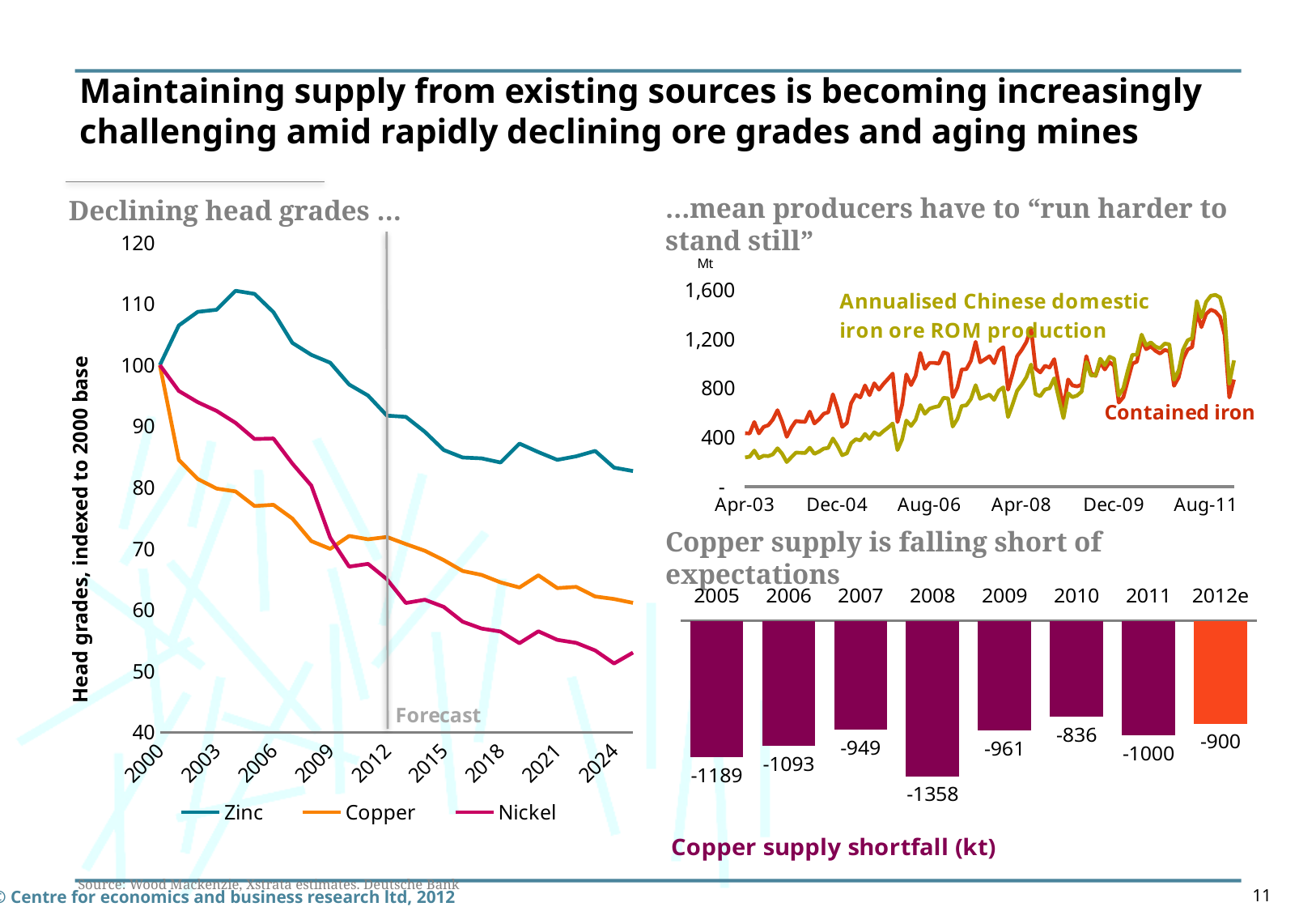
What kind of chart is the 'Copper supply is falling short of expectations' chart? Bar chart In the 'Copper supply is falling short of expectations' chart, which year shows the larger shortfall, 2011 or 2012e? 2011 How many bars are in the 'Copper supply is falling short of expectations' chart? 8 In the 'Copper supply is falling short of expectations' chart, which year has the lowest value? 2008 In the 'Copper supply is falling short of expectations' chart, which year has the highest value? 2010 How many series does the legend of the 'Declining head grades ...' chart list? 3 In the 'Copper supply is falling short of expectations' chart, what is the value for 2008? -1358 In the 'Declining head grades ...' chart, is the value for Nickel in 2024 greater or less than 60? less In the 'Declining head grades ...' chart, which series is higher in 2012, Zinc or Nickel? Zinc In the 'Copper supply is falling short of expectations' chart, what is the difference between the values for 2005 and 2006? 96 In the 'Copper supply is falling short of expectations' chart, what is the value for 2012e? -900 In the 'Declining head grades ...' chart, does the Nickel series rise or fall from 2000 to 2024? Fall